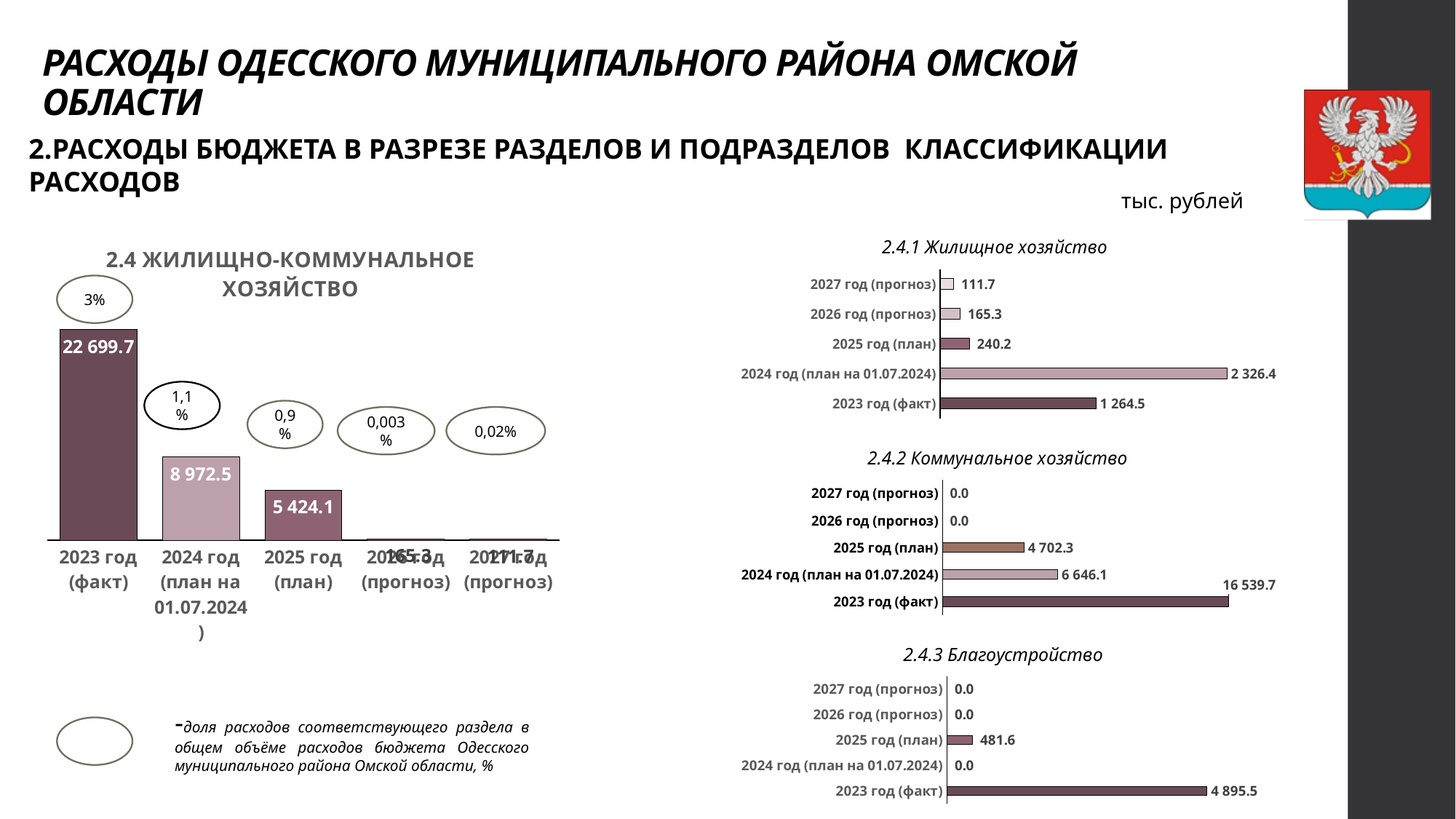
In the chart '2.4.1 Жилищное хозяйство', what is the difference between the values for 2023 год (факт) and 2025 год (план)? 1 024.3 In the chart '2.4.1 Жилищное хозяйство', which category has the lowest value? 2027 год (прогноз) In the chart '2.4.2 Коммунальное хозяйство', which is larger: the value for 2024 год (план на 01.07.2024) or 2025 год (план)? 2024 год (план на 01.07.2024) In the chart '2.4.3 Благоустройство', what is the value for 2025 год (план)? 481.6 In the chart '2.4 ЖИЛИЩНО-КОММУНАЛЬНОЕ ХОЗЯЙСТВО', do the values rise or fall from 2023 год (факт) to 2025 год (план)? fall In the chart '2.4.1 Жилищное хозяйство', what is the value for 2024 год (план на 01.07.2024)? 2 326.4 In the chart '2.4.1 Жилищное хозяйство', which category has the highest value? 2024 год (план на 01.07.2024) What type of chart is '2.4.3 Благоустройство'? bar chart In the chart '2.4.2 Коммунальное хозяйство', how many categories are shown? 5 In the chart '2.4 ЖИЛИЩНО-КОММУНАЛЬНОЕ ХОЗЯЙСТВО', what is the value for 2023 год (факт)? 22 699.7 In the chart '2.4.2 Коммунальное хозяйство', what is the value for 2023 год (факт)? 16 539.7 In the chart '2.4.3 Благоустройство', what is the difference between the values for 2023 год (факт) and 2025 год (план)? 4 413.9